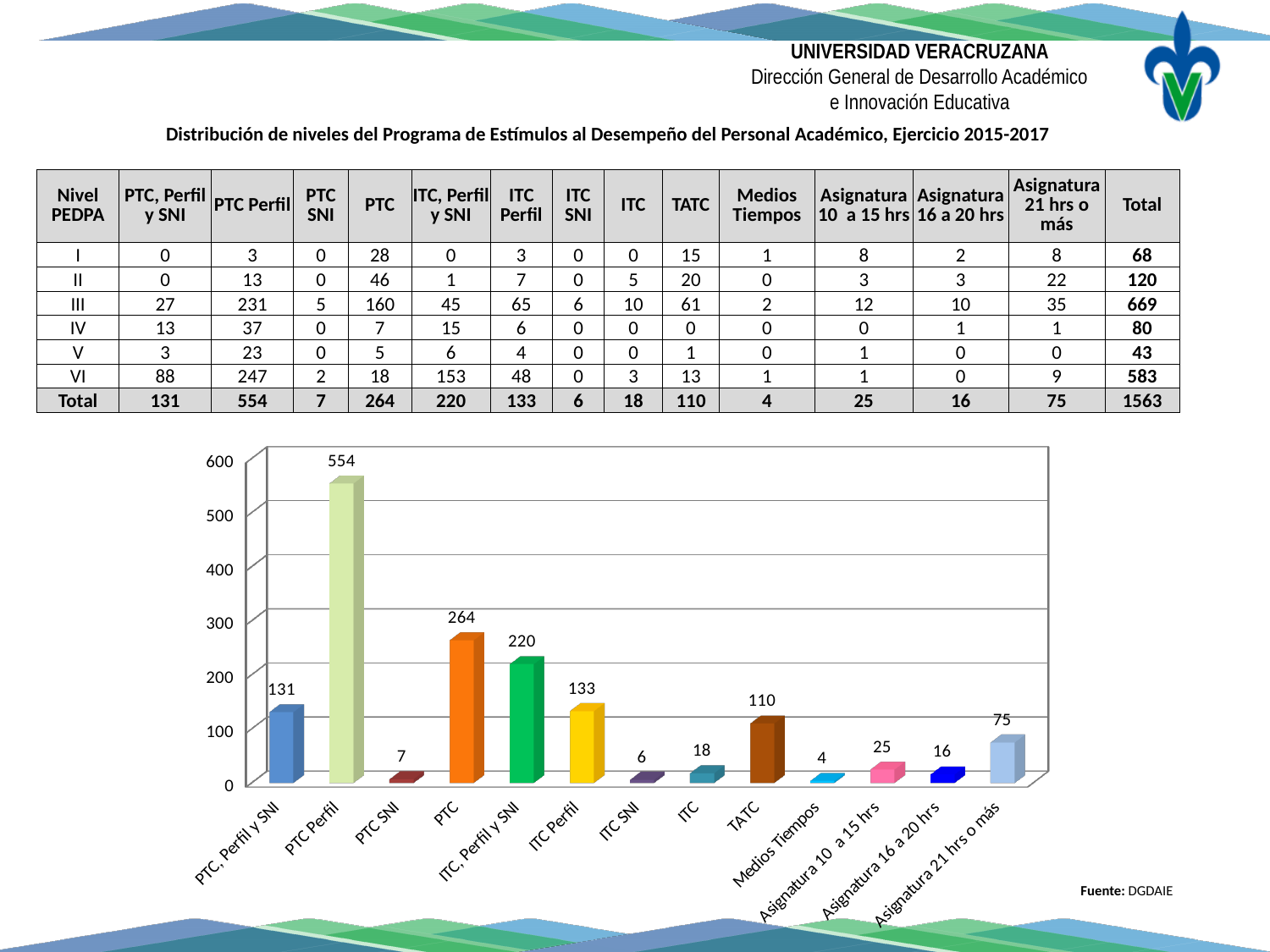
Is the value for PTC Perfil greater or less than 500? greater How many categories are shown on the x axis of the chart? 13 What is the difference between the values for PTC and ITC Perfil? 131 Which category has the highest bar in the chart? PTC Perfil What kind of chart is shown on the slide? bar chart What is the value of the bar for PTC Perfil? 554 What source is cited below the chart? DGDAIE What is the difference between the values for Asignatura 10 a 15 hrs and Asignatura 16 a 20 hrs? 9 What is the value of the bar for Asignatura 21 hrs o más? 75 Which is larger, the value for PTC, Perfil y SNI or the value for TATC? PTC, Perfil y SNI Which category has the lowest bar in the chart? Medios Tiempos What is the value of the bar for ITC, Perfil y SNI? 220